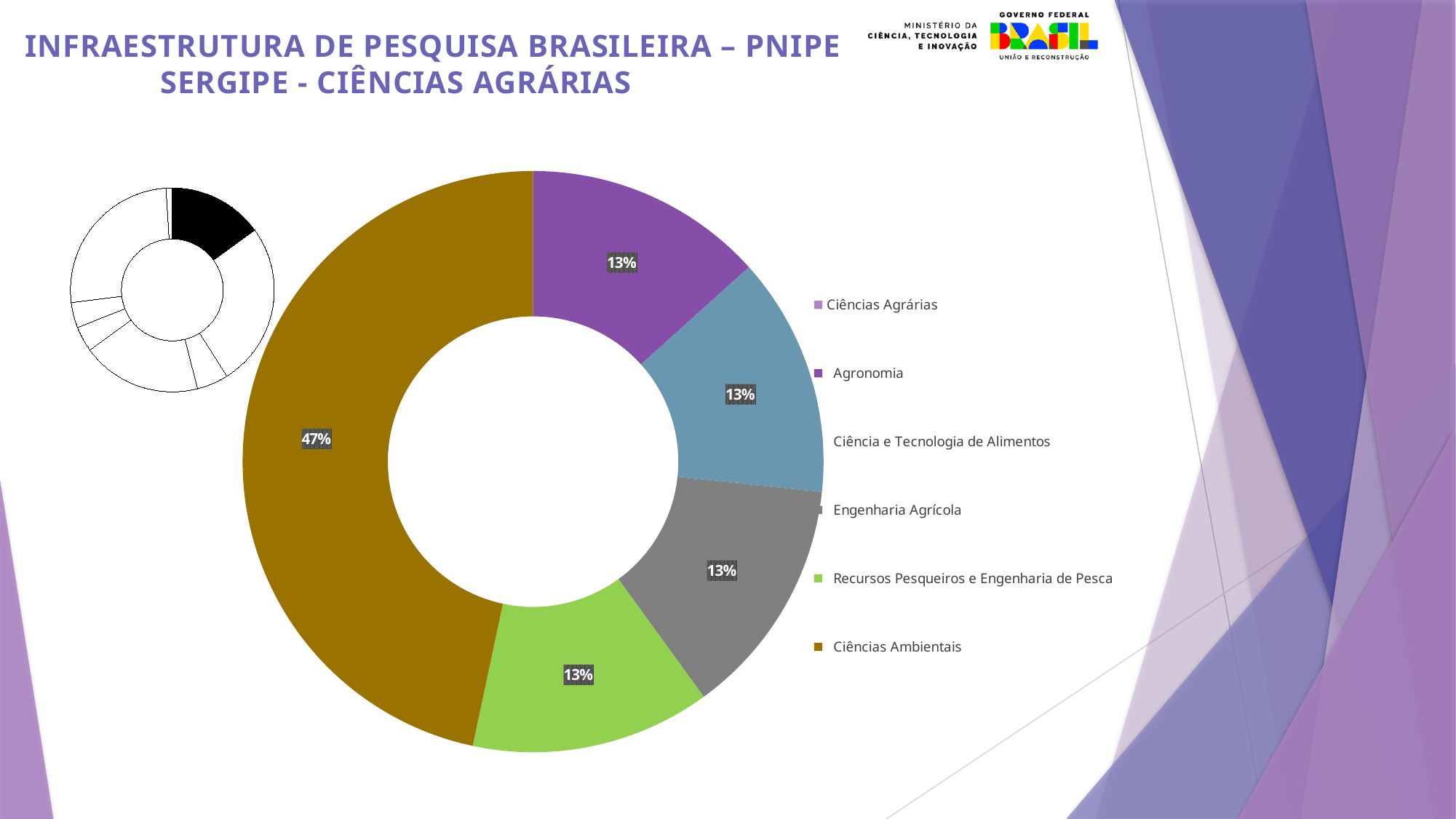
What colour is the Ciências Ambientais slice in the donut chart? brown/gold What kind of chart is shown in the centre of the slide? donut (pie) chart What percentage is shown for Ciências Ambientais? 47% What percentage is shown for Engenharia Agrícola? 13% How many entries does the legend of the donut chart list? 6 What is the difference in percentage points between Ciências Ambientais and Engenharia Agrícola? 34 percentage points Which category has the largest slice in the donut chart? Ciências Ambientais What percentage is shown for Recursos Pesqueiros e Engenharia de Pesca? 13% What is the second line of the slide title? SERGIPE - CIÊNCIAS AGRÁRIAS Is the share for Ciências Ambientais greater or less than 50%? less How many slices with data labels does the donut chart have? 5 Which is larger, the slice for Ciências Ambientais or the slice for Recursos Pesqueiros e Engenharia de Pesca? Ciências Ambientais